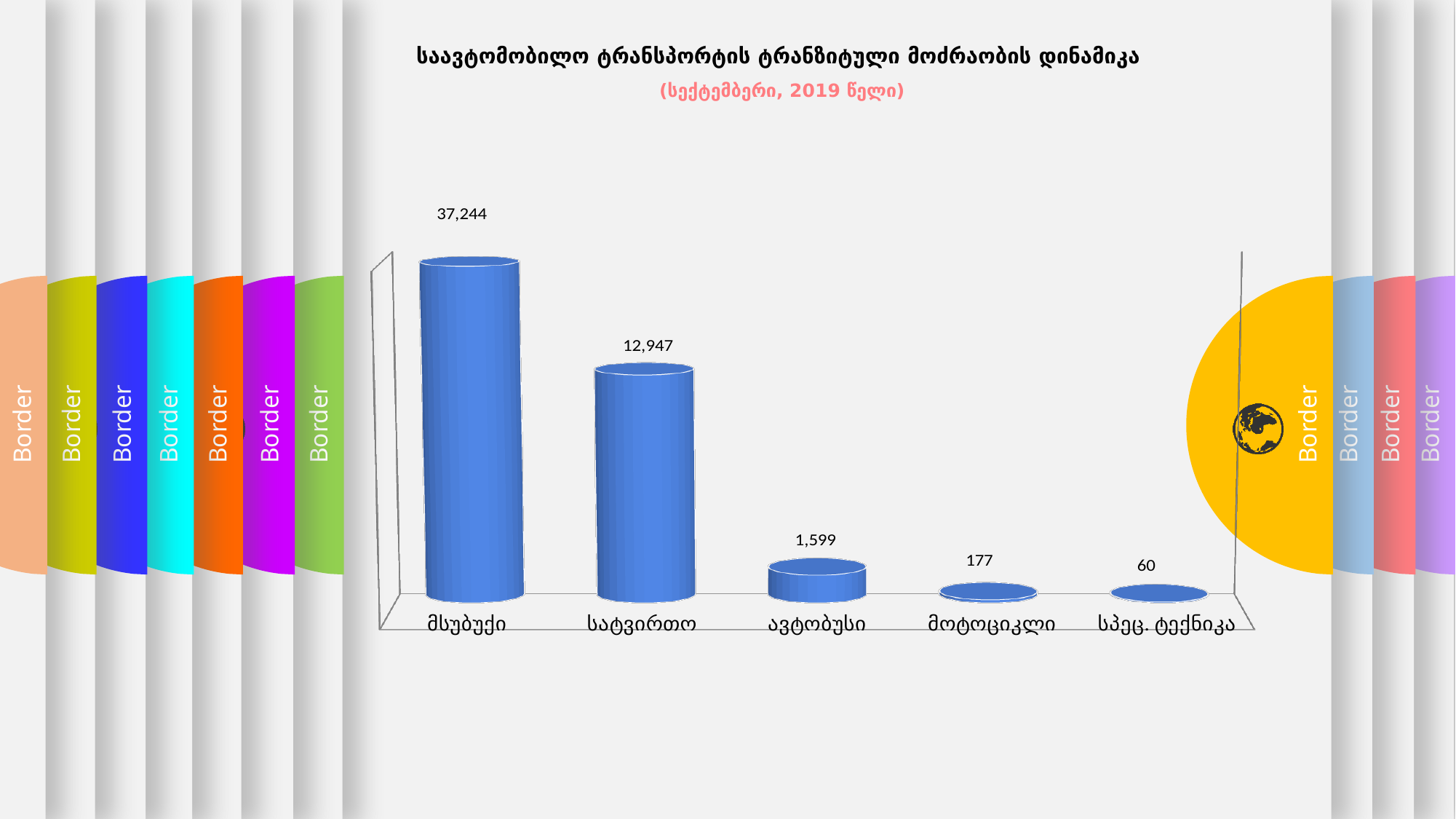
What kind of chart is shown on the slide? Bar chart How many categories are shown in the chart? 5 What is the value for სპეც. ტექნიკა? 60 What is the value for ავტობუსი? 1,599 Do the values rise or fall from left to right along the x axis? Fall Which category has the highest value? მსუბუქი What is the value for მსუბუქი? 37,244 Which is larger, the value for ავტობუსი or the value for მოტოციკლი? ავტობუსი Which category has the lowest value? სპეც. ტექნიკა What is the difference between the values for მსუბუქი and სატვირთო? 24,297 What is the value for სატვირთო? 12,947 What is the value for მოტოციკლი? 177